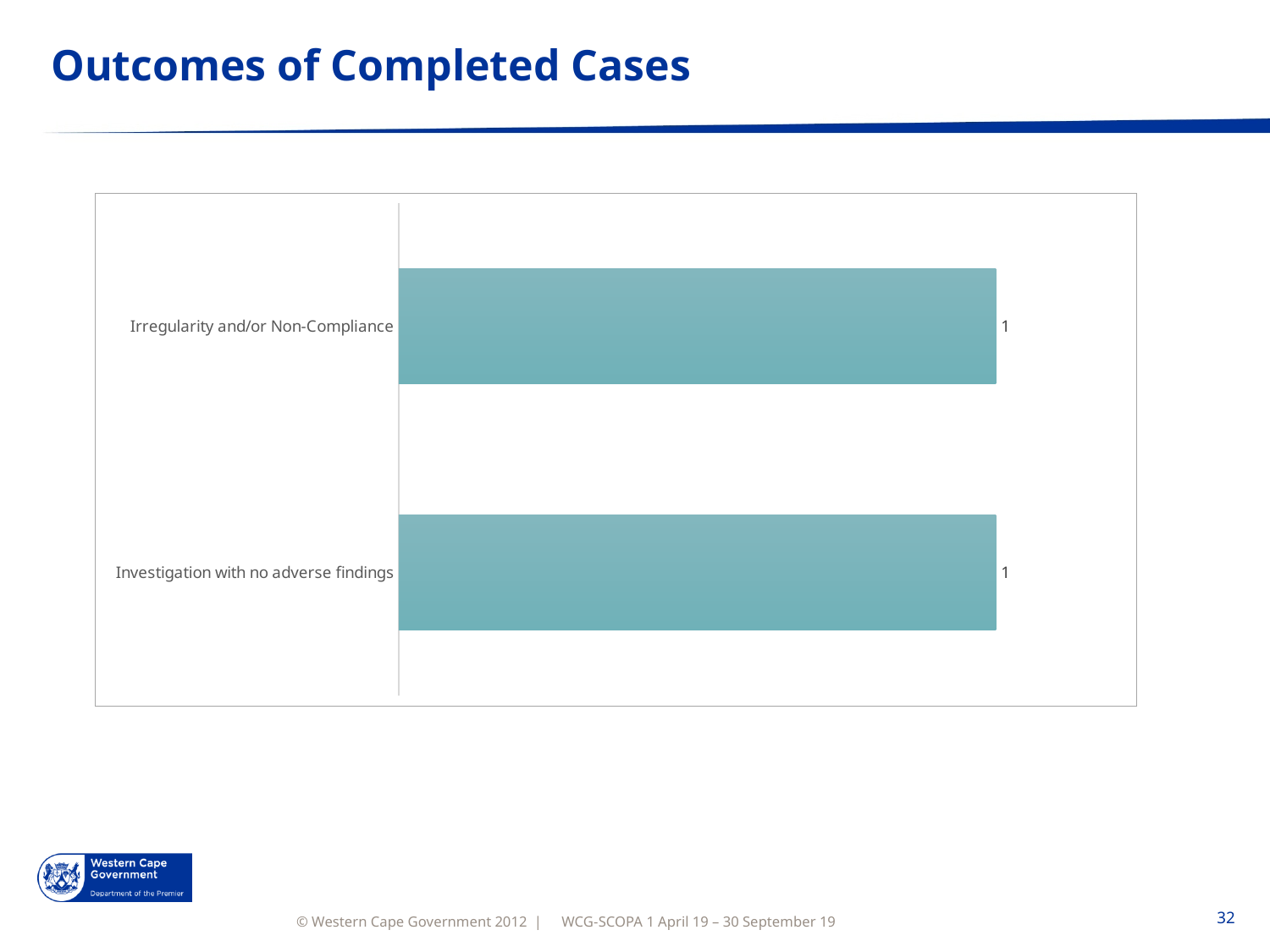
What is the difference between the values for Irregularity and/or Non-Compliance and Investigation with no adverse findings? 0 How many categories are shown in the chart? 2 What is the value for Irregularity and/or Non-Compliance? 1 Are the bars in the chart horizontal or vertical? Horizontal What is the title of the slide containing the chart? Outcomes of Completed Cases What is the total of the values for the two categories shown? 2 What is the value for Investigation with no adverse findings? 1 What kind of chart is shown on the slide? Bar chart